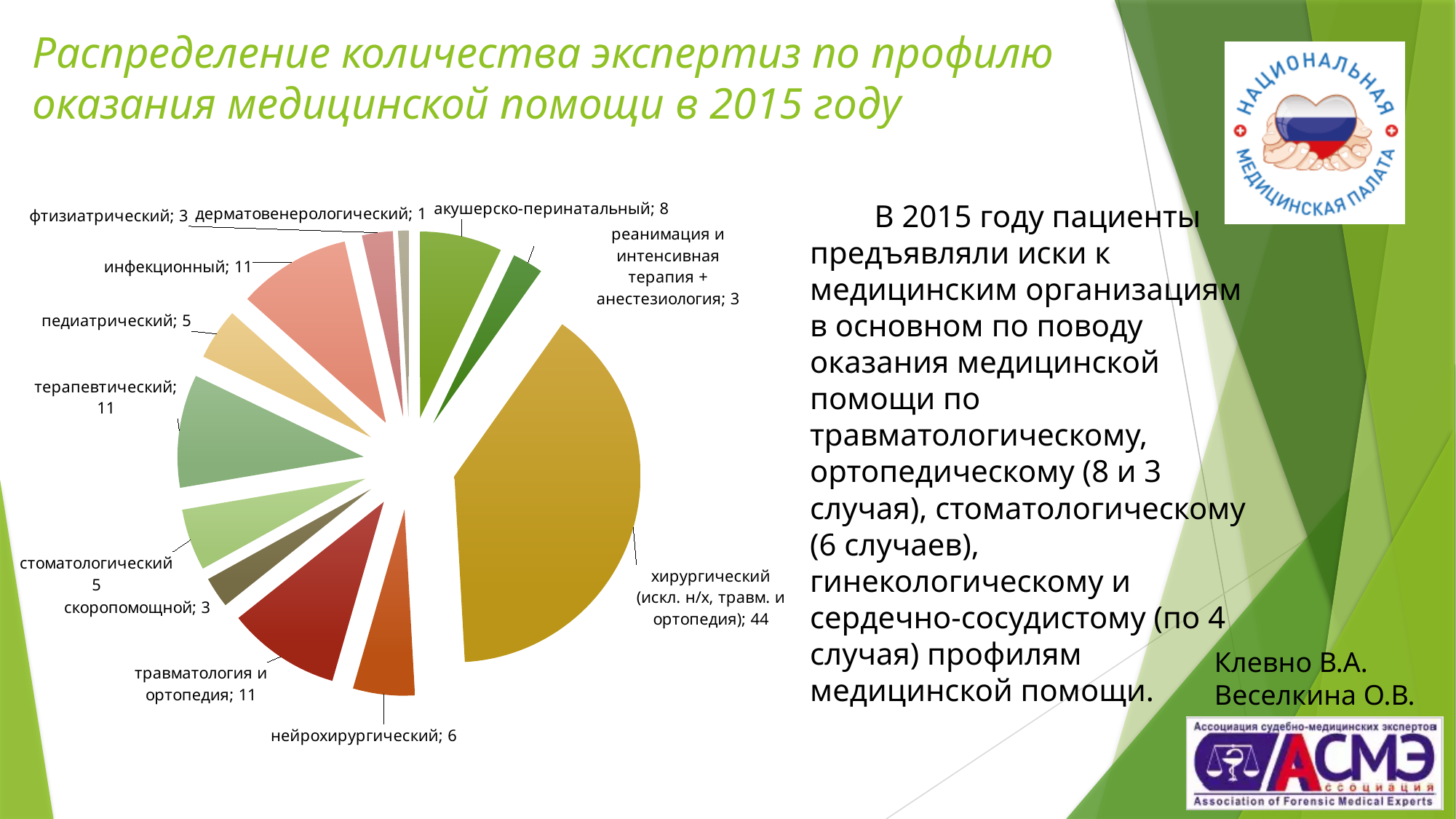
What is the difference between the values for акушерско-перинатальный and фтизиатрический? 5 What is the value for акушерско-перинатальный? 8 What is the value for хирургический (искл. н/х, травм. и ортопедия)? 44 How many categories (slices) does the pie chart have? 12 Which category has the largest slice of the pie? хирургический (искл. н/х, травм. и ортопедия) What kind of chart is shown on the slide? pie chart Which is larger, the value for инфекционный or the value for педиатрический? инфекционный What is the difference between the values for хирургический (искл. н/х, травм. и ортопедия) and травматология и ортопедия? 33 What is the value for нейрохирургический? 6 What is the value for педиатрический? 5 What is the title of the slide containing the chart? Распределение количества экспертиз по профилю оказания медицинской помощи в 2015 году Which category has the smallest slice of the pie? дерматовенерологический